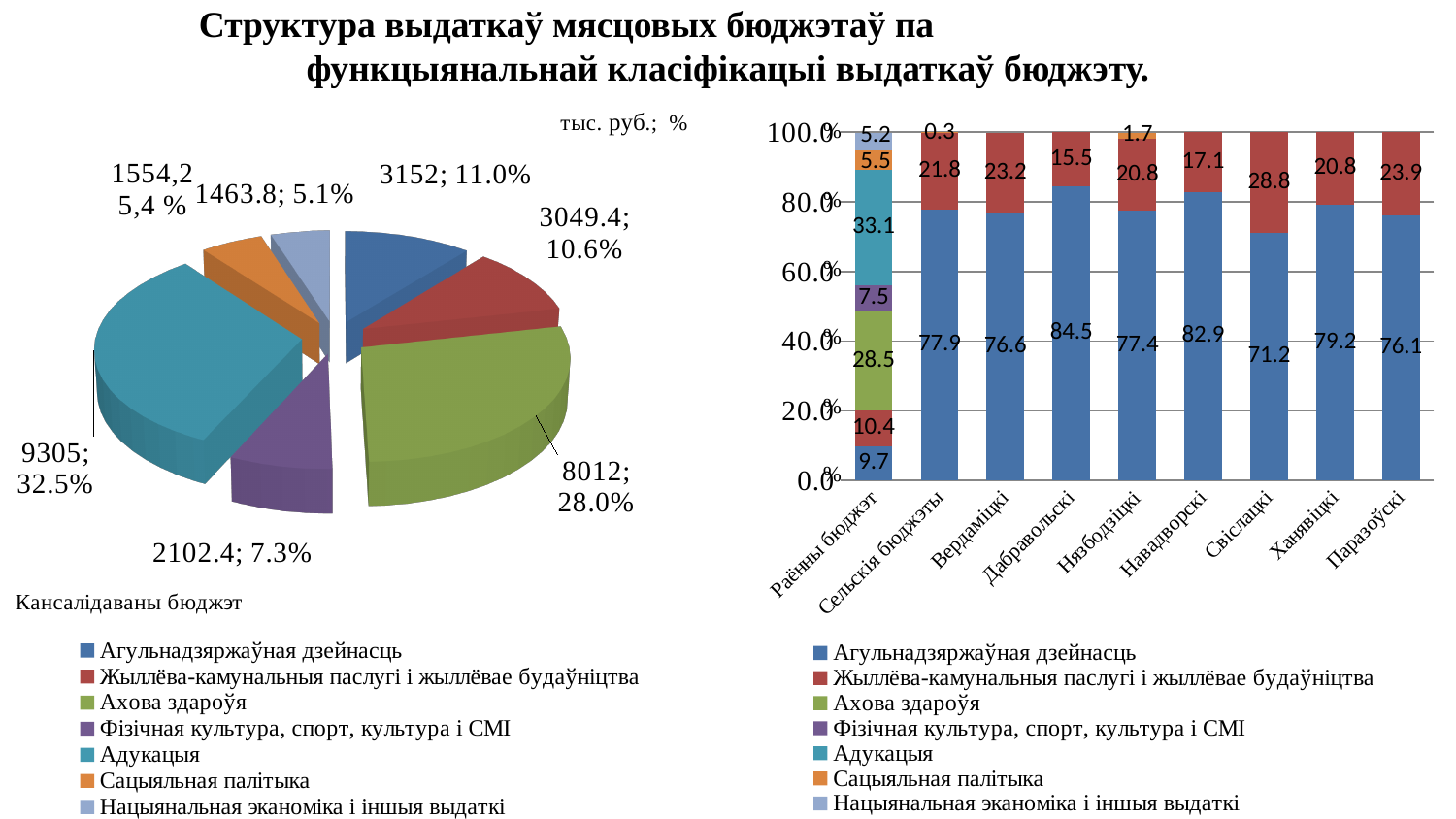
In the pie chart on the left, which category has the smallest share? Нацыянальная эканоміка і іншыя выдаткі What type of chart is on the left side of the slide? Pie chart How many series does the legend of the stacked bar chart on the right list? 7 In the stacked bar chart on the right, what is the difference between the Жыллёва-камунальныя паслугі values for Свіслацкі and Навадворскі? 11.7 In the stacked bar chart on the right, which category has the highest value for Агульнадзяржаўная дзейнасць? Дабравольскі In the stacked bar chart on the right, how many categories are shown on the x axis? 9 In the pie chart on the left, how many slices are there? 7 In the pie chart on the left, what percentage share does Ахова здароўя have? 28.0% In the pie chart on the left, which category has the largest share? Адукацыя In the stacked bar chart on the right, what is the value of Агульнадзяржаўная дзейнасць for Дабравольскі? 84.5 In the pie chart on the left, what value is shown for Адукацыя? 9305; 32.5% In the stacked bar chart on the right, what is the value of Адукацыя for Раённы бюджэт? 33.1